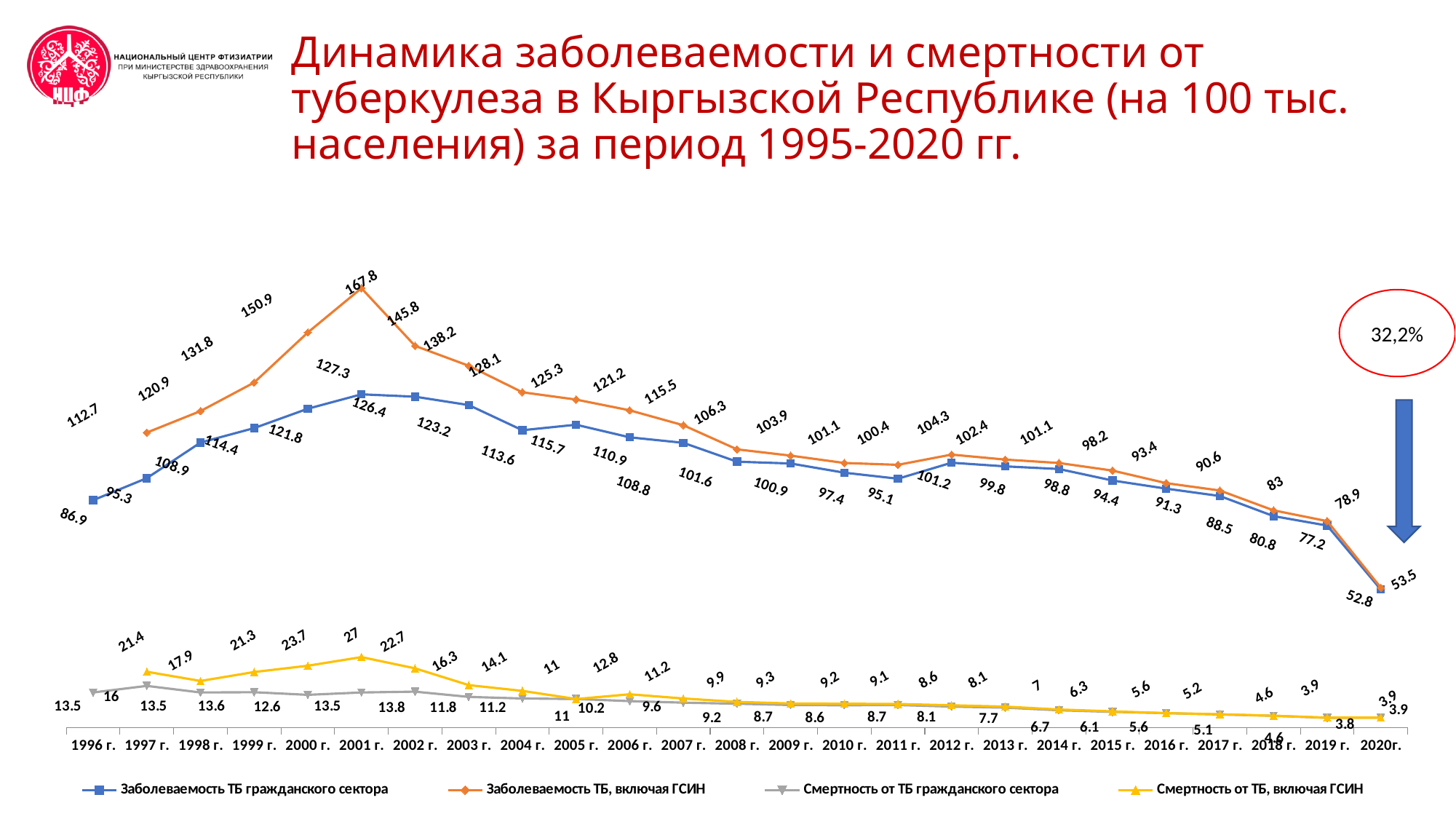
What is the highest value of the series 'Заболеваемость ТБ, включая ГСИН'? 167.8 What is the value of 'Заболеваемость ТБ гражданского сектора' in 1996 г.? 86.9 What is the difference between 'Заболеваемость ТБ, включая ГСИН' at its 2001 г. peak (167.8) and its 2020 г. value (53.5)? 114.3 In which year does 'Заболеваемость ТБ, включая ГСИН' reach its peak? 2001 г. What kind of chart is shown on the slide? Line chart Overall, do the incidence lines rise or fall from 2001 г. to 2020 г.? Fall What percentage is shown in the red circle next to the downward arrow? 32,2% What is the highest value of 'Смертность от ТБ, включая ГСИН'? 27 What is the value of 'Заболеваемость ТБ, включая ГСИН' in 2020 г.? 53.5 How many years are shown on the x axis? 25 What is the value of 'Заболеваемость ТБ гражданского сектора' in 2020 г.? 52.8 How many series does the legend list? 4